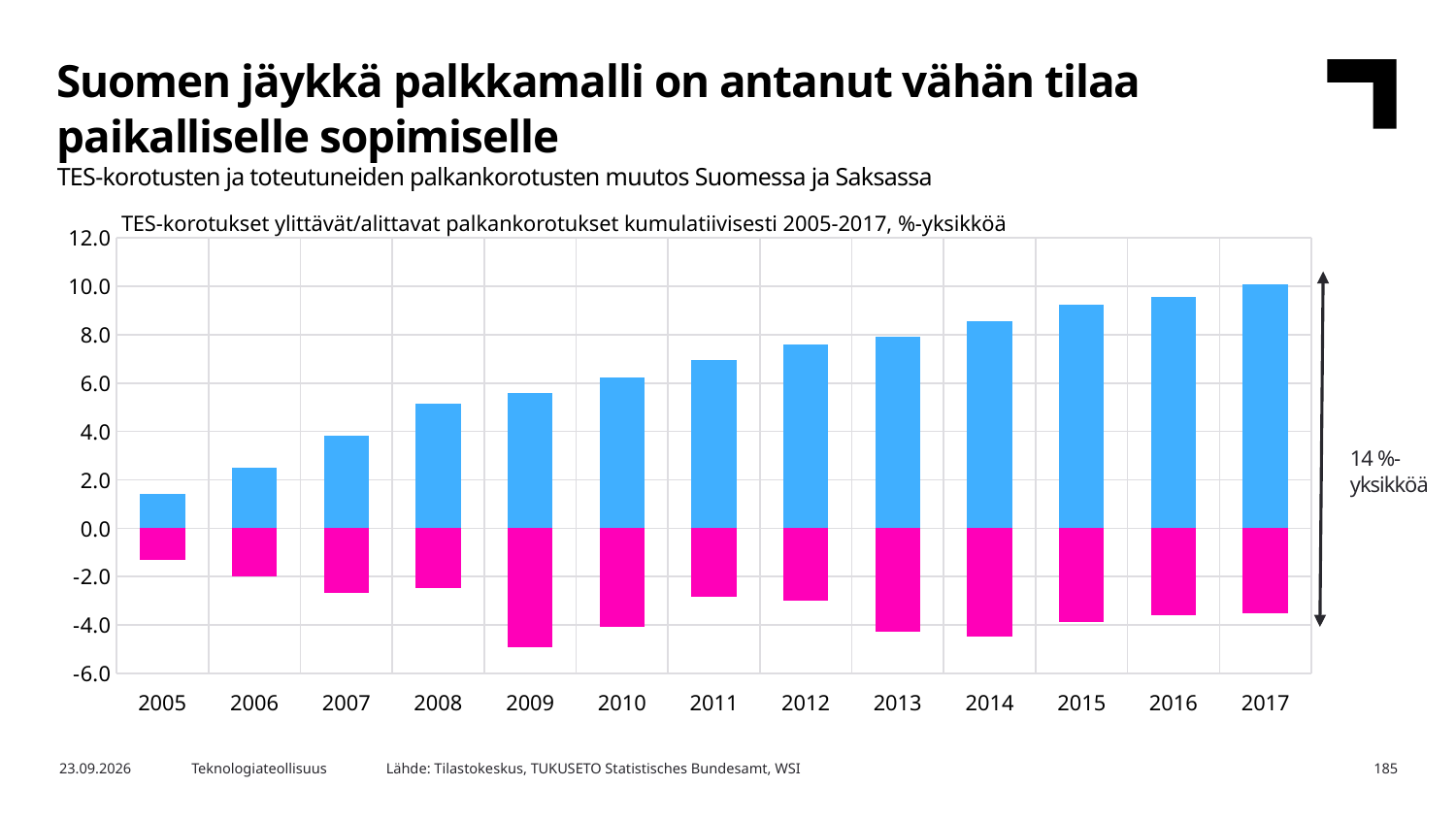
How many years are shown on the x axis of the chart? 13 Which blue bar is larger, 2010 or 2012? 2012 Do the blue bars rise or fall from 2005 to 2017? rise Is the value of the blue bar for 2005 greater or less than 2.0? less In which year is the blue bar the lowest? 2005 What is the highest value shown on the chart's vertical axis? 12.0 What kind of chart is shown on the slide? bar chart Which year has the longest magenta (negative) bar? 2009 What value does the annotation with the arrow on the right side of the chart state? 14 %-yksikköä Is the value of the magenta bar for 2009 greater or less than -4.0? less Is the value of the blue bar for 2017 greater or less than 8.0? greater In which year is the blue bar the highest? 2017